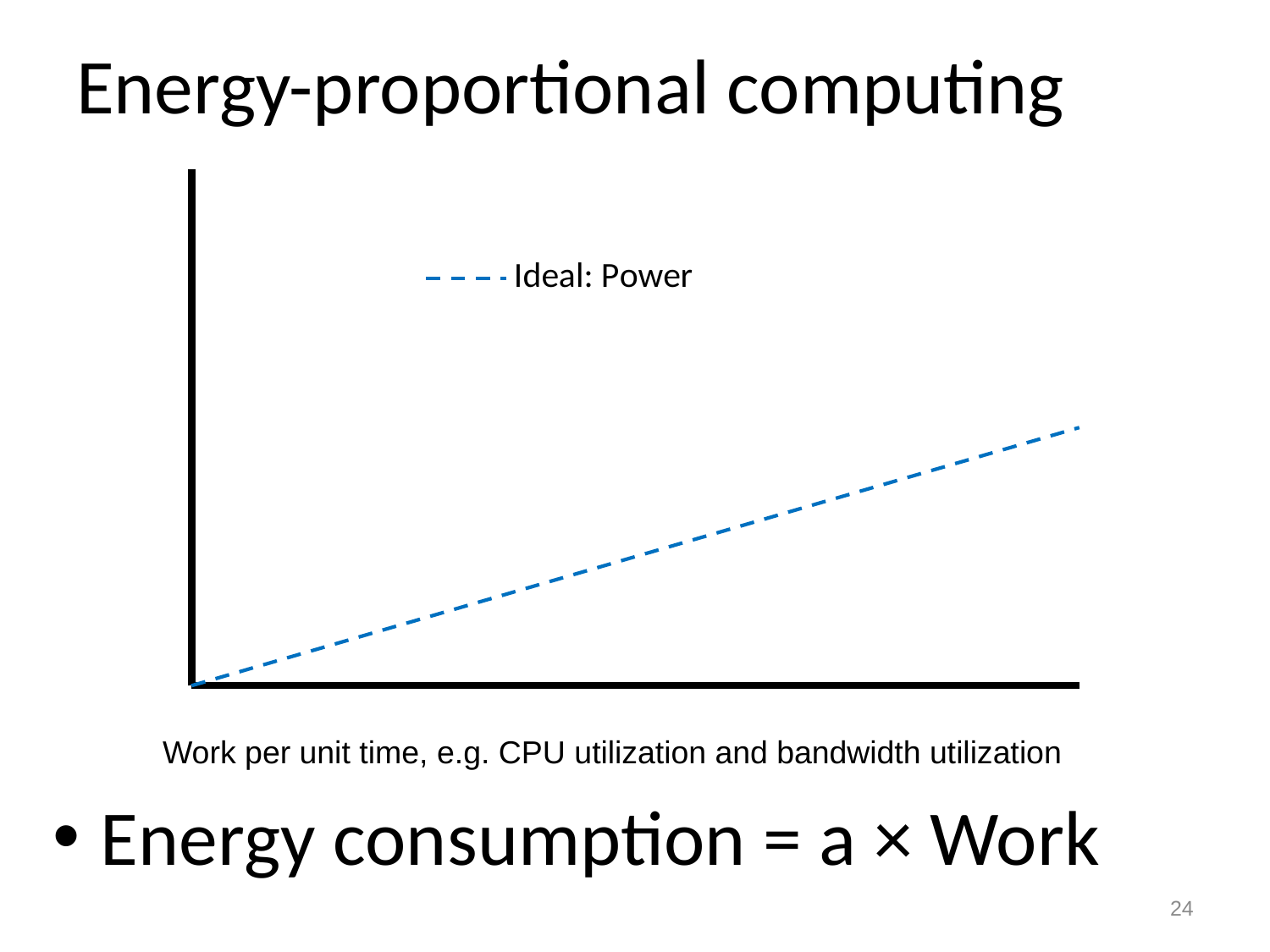
How many series does the chart's legend list? 1 Does the Ideal: Power line rise or fall as you move from left to right along the x axis? rise Is the Ideal: Power line drawn as a solid or a dashed line? dashed What kind of chart is shown on the slide? line chart What is the name of the series shown in the chart's legend? Ideal: Power